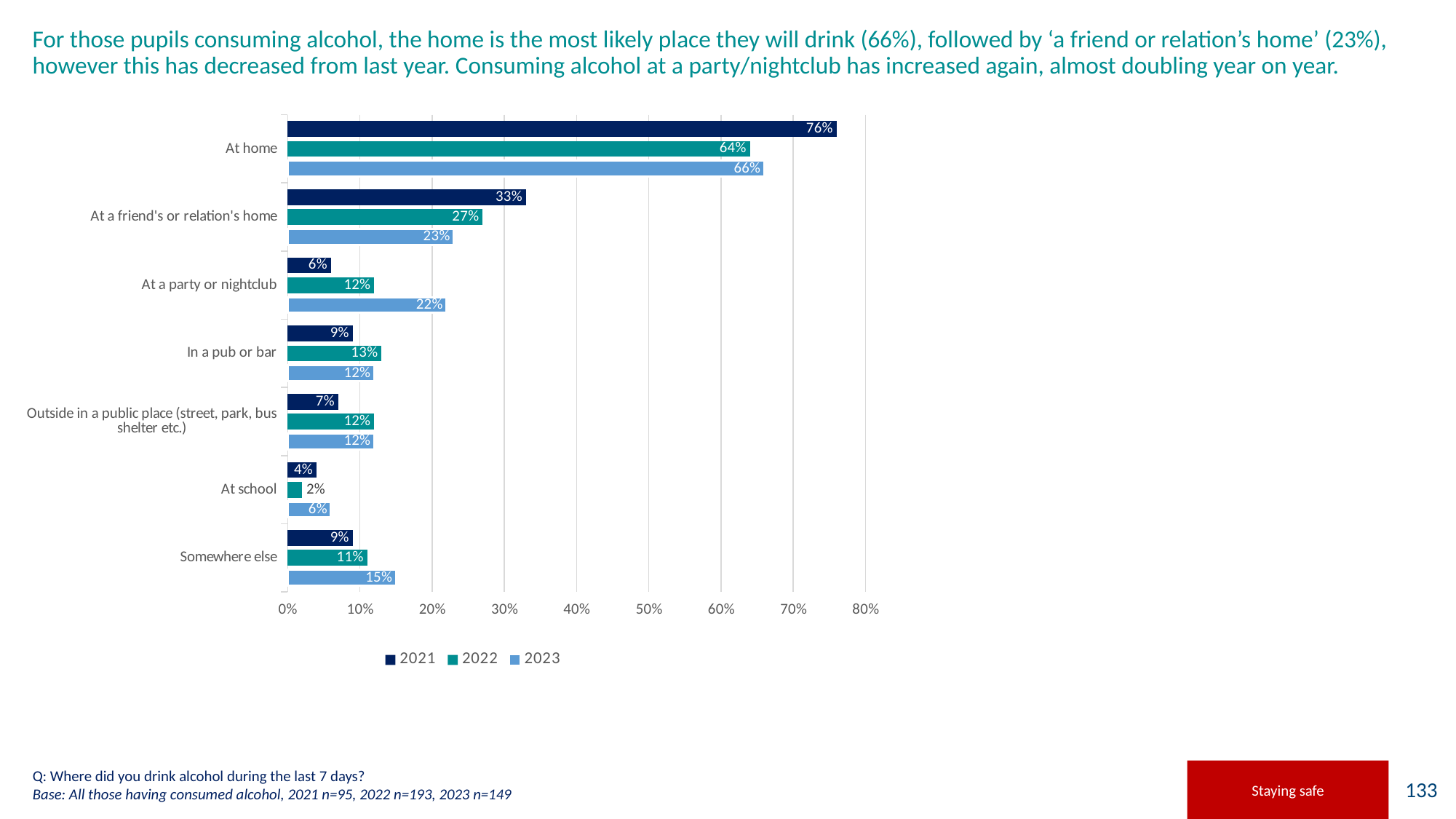
How many categories are shown on the chart? 7 Which is larger: the 2023 value for 'At a party or nightclub' or the 2023 value for 'Somewhere else'? At a party or nightclub What kind of chart is shown on the slide? Bar chart Which category has the highest 2023 value? At home What is the difference between the 2021 and 2023 values for 'At home'? 10% Which years are listed in the chart legend? 2021, 2022, 2023 What is the 2022 value for 'At school'? 2% How many series does the legend list? 3 What is the 2021 value for 'At a friend's or relation's home'? 33% Which category has the lowest 2022 value? At school What is the 2023 value for 'At home'? 66% What is the difference between the 2022 and 2023 values for 'At a party or nightclub'? 10%